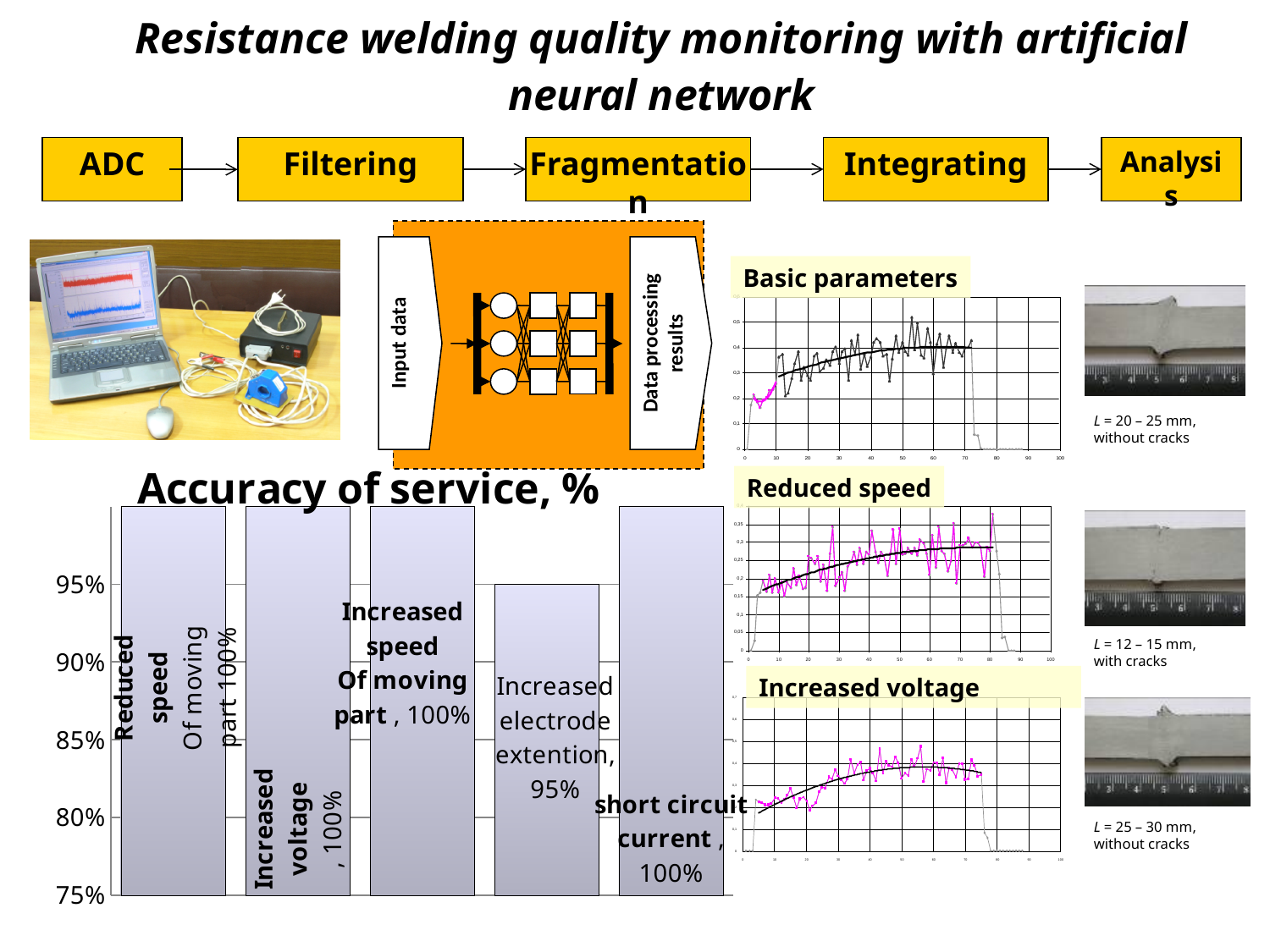
On the 'Accuracy of service, %' chart, what is the value for Increased voltage? 100% On the 'Accuracy of service, %' chart, which category has the lowest value? Increased electrode extention On the 'Accuracy of service, %' chart, what is the value for short circuit current? 100% On the 'Accuracy of service, %' chart, is the value for Increased electrode extention greater or less than 90%? greater What kind of chart is the 'Reduced speed' chart on the right side of the slide? line chart What is the lowest value shown on the vertical axis of the 'Accuracy of service, %' chart? 75% How many bars are shown on the 'Accuracy of service, %' chart? 5 On the 'Accuracy of service, %' chart, which is larger: the value for short circuit current or the value for Increased electrode extention? short circuit current What kind of chart is the 'Accuracy of service, %' chart? bar chart On the 'Accuracy of service, %' chart, what is the value for Increased speed of moving part? 100% On the 'Accuracy of service, %' chart, what is the value for Increased electrode extention? 95% On the 'Accuracy of service, %' chart, what is the difference between the value for Increased voltage and the value for Increased electrode extention? 5%